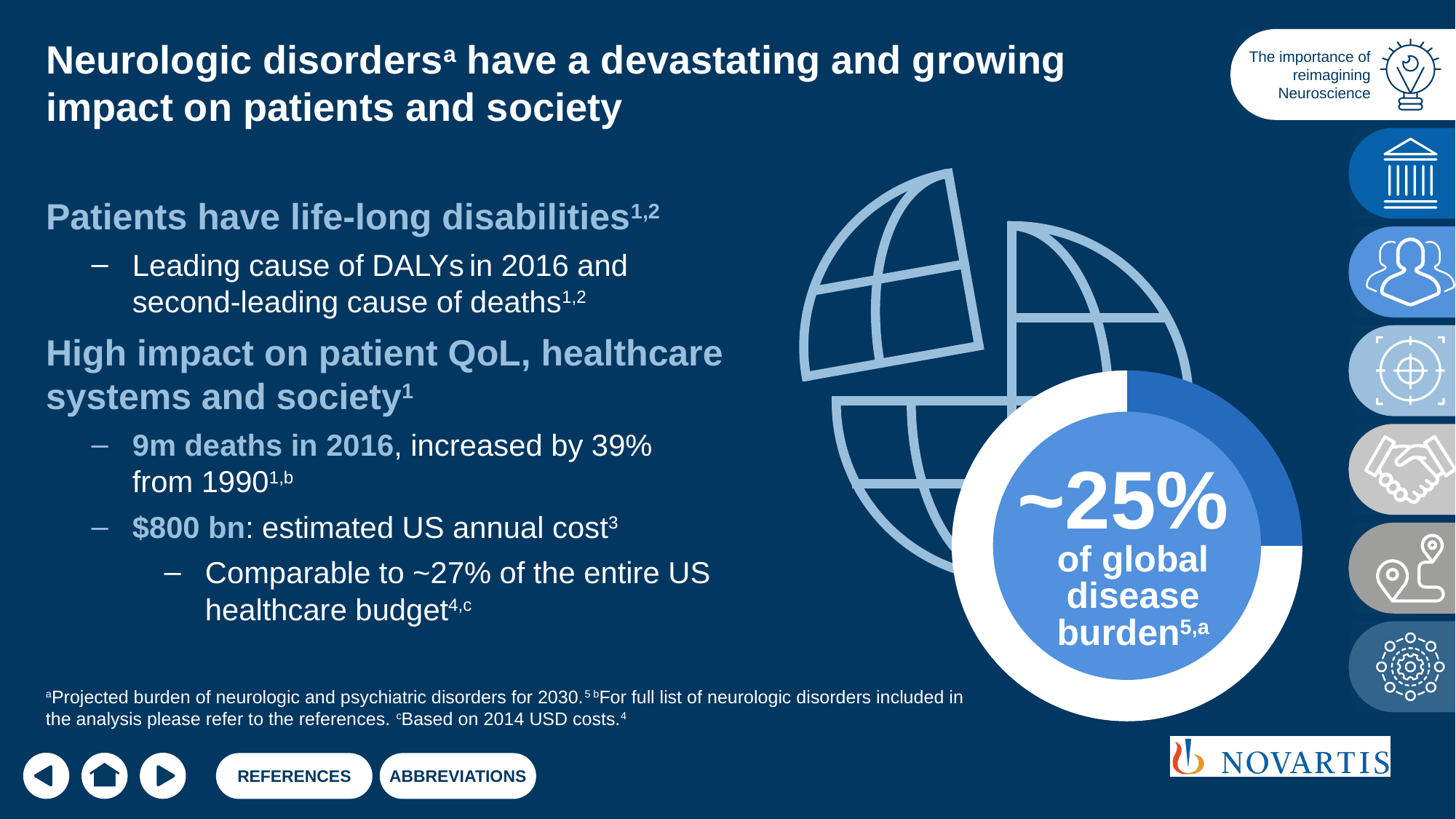
What kind of chart is shown on the right side of the slide? Donut chart How many segments does the donut chart have? 2 What share of global disease burden does the donut chart show for neurologic disorders? ~25% What does the highlighted segment of the donut chart represent? Share of global disease burden Which segment of the donut chart is larger, the blue highlighted segment or the white remainder? The white remainder What colour is the highlighted segment of the donut chart? Blue Is the highlighted share in the donut chart greater or less than 50%? less